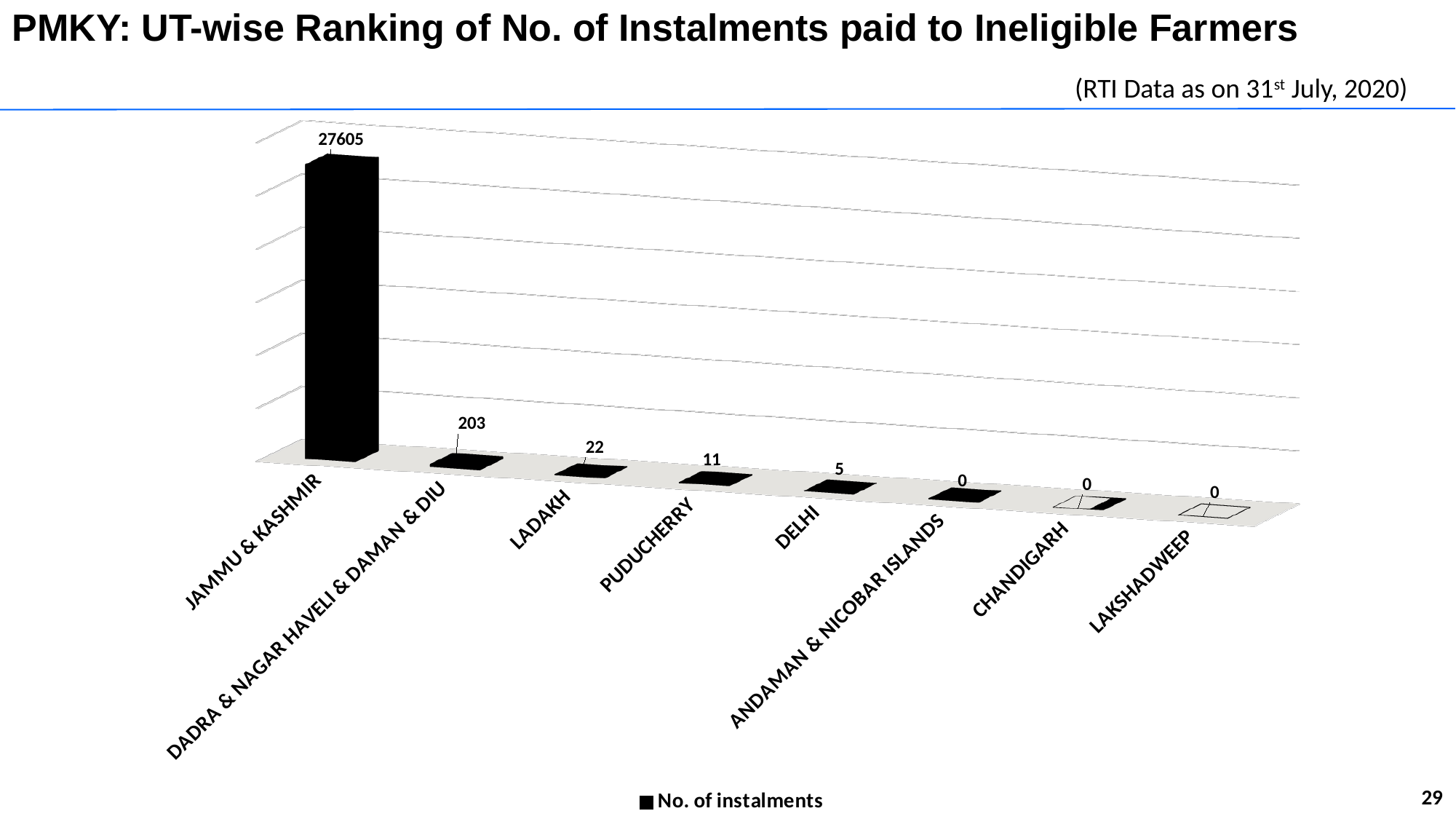
What is the number of instalments paid to ineligible farmers in Jammu & Kashmir? 27605 What is the difference in number of instalments between Jammu & Kashmir and Dadra & Nagar Haveli & Daman & Diu? 27402 What is the number of instalments for Dadra & Nagar Haveli & Daman & Diu? 203 What is the number of instalments for Ladakh? 22 What is the number of instalments for Delhi? 5 How many UTs are shown on the chart? 8 Which UT has the highest number of instalments paid to ineligible farmers? Jammu & Kashmir What kind of chart is shown on the slide? Bar chart What is the number of instalments for Puducherry? 11 Which has more instalments, Puducherry or Delhi? Puducherry What is the difference in number of instalments between Ladakh and Puducherry? 11 What series name is listed in the chart legend? No. of instalments